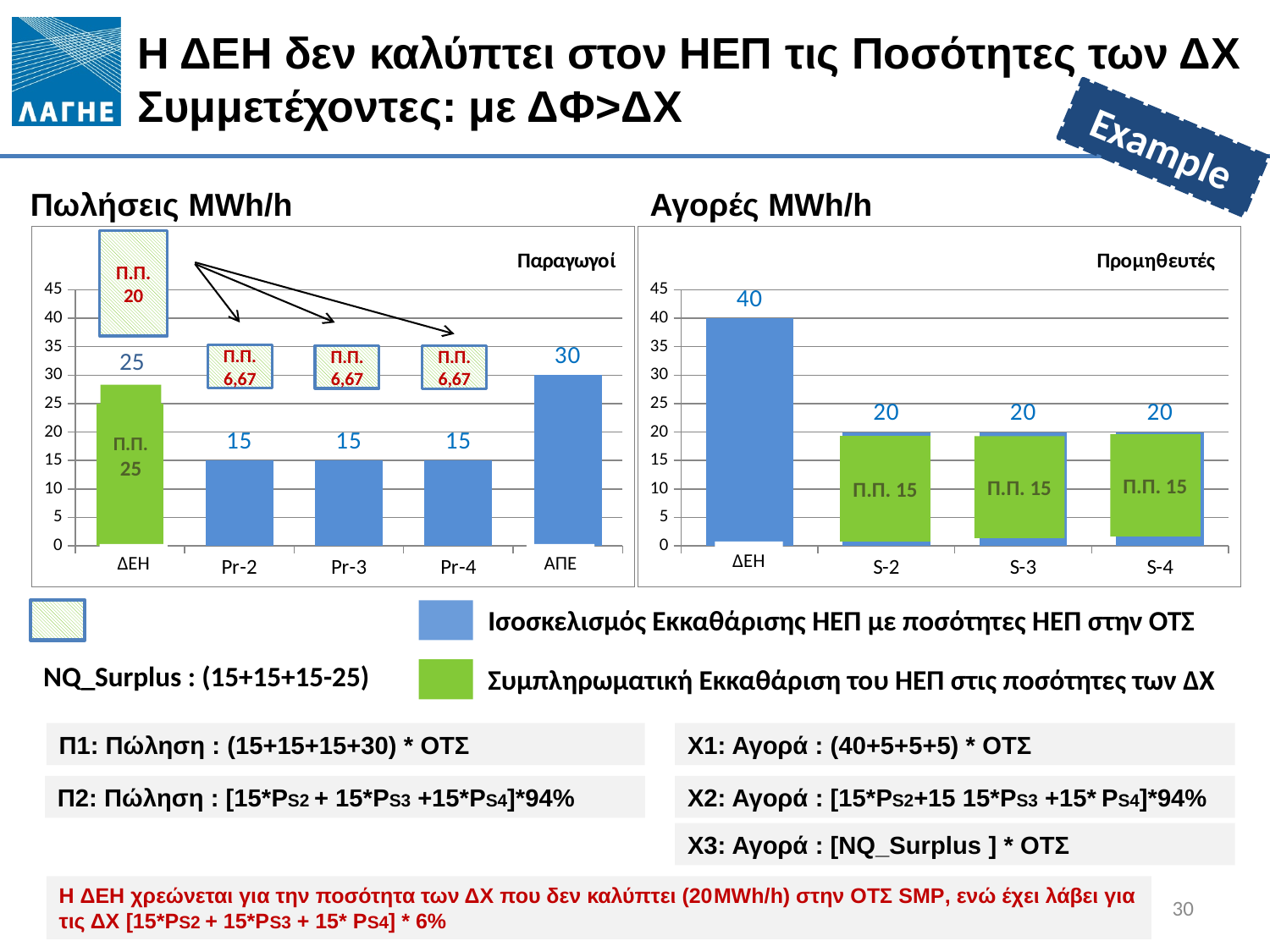
Is the value for ΔΕΗ in the 'Πωλήσεις MWh/h' chart larger or smaller than the value for ΔΕΗ in the 'Αγορές MWh/h' chart? smaller In the 'Αγορές MWh/h' chart, which category has the highest labelled value? ΔΕΗ In the 'Πωλήσεις MWh/h' chart, how many categories are shown on the x axis? 5 What kind of chart is the 'Αγορές MWh/h' chart? bar chart In the 'Αγορές MWh/h' chart, what is the value labelled for S-4? 20 In the 'Αγορές MWh/h' chart, how many categories are shown on the x axis? 4 In the 'Πωλήσεις MWh/h' chart, what is the value labelled for ΑΠΕ? 30 In the 'Πωλήσεις MWh/h' chart, what is the difference between the labelled values for ΑΠΕ and ΔΕΗ? 5 In the 'Πωλήσεις MWh/h' chart, which category has the highest labelled value? ΑΠΕ In the 'Αγορές MWh/h' chart, what is the difference between the labelled values for ΔΕΗ and S-2? 20 In the 'Πωλήσεις MWh/h' chart, what is the value labelled for Pr-3? 15 In the 'Αγορές MWh/h' chart, what is the value labelled for ΔΕΗ? 40